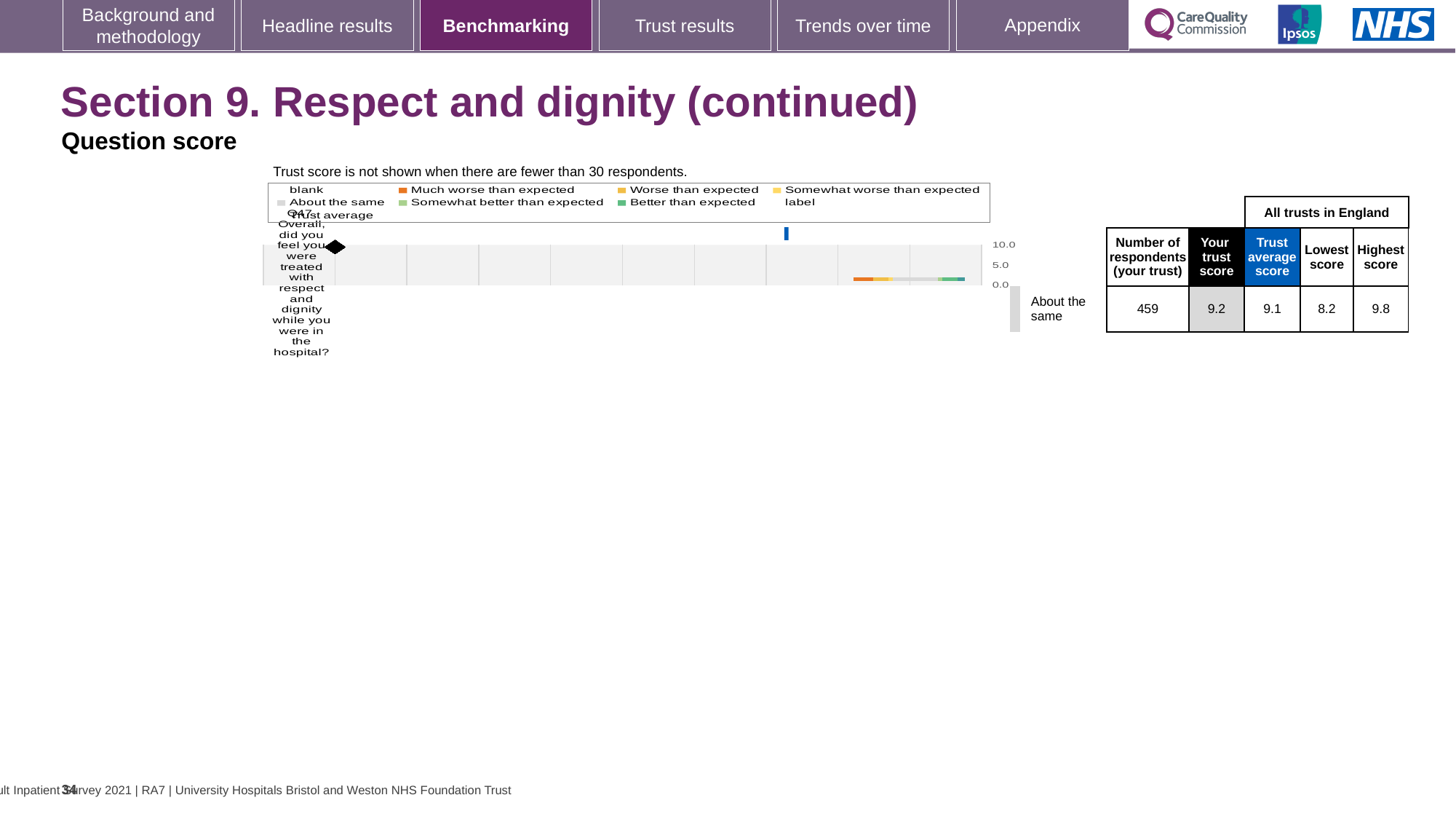
According to the table next to the chart, what is the lowest score among all trusts in England for Q47? 8.2 How is the trust's result for Q47 categorised next to the chart? About the same According to the table next to the chart, how many respondents from the trust answered Q47? 459 What kind of chart is shown on the slide? bar chart What is the highest value shown on the chart's vertical axis? 10.0 According to the table next to the chart, what is the highest score among all trusts in England for Q47? 9.8 What is the difference between the highest score and the lowest score for Q47 in the table next to the chart? 1.6 Which is larger for Q47: the trust's score or the trust average score? the trust's score Which question number is plotted on the chart? Q47 How many questions (categories) are plotted on the chart? 1 According to the table next to the chart, what is the trust's score for Q47? 9.2 According to the table next to the chart, what is the trust average score for Q47? 9.1